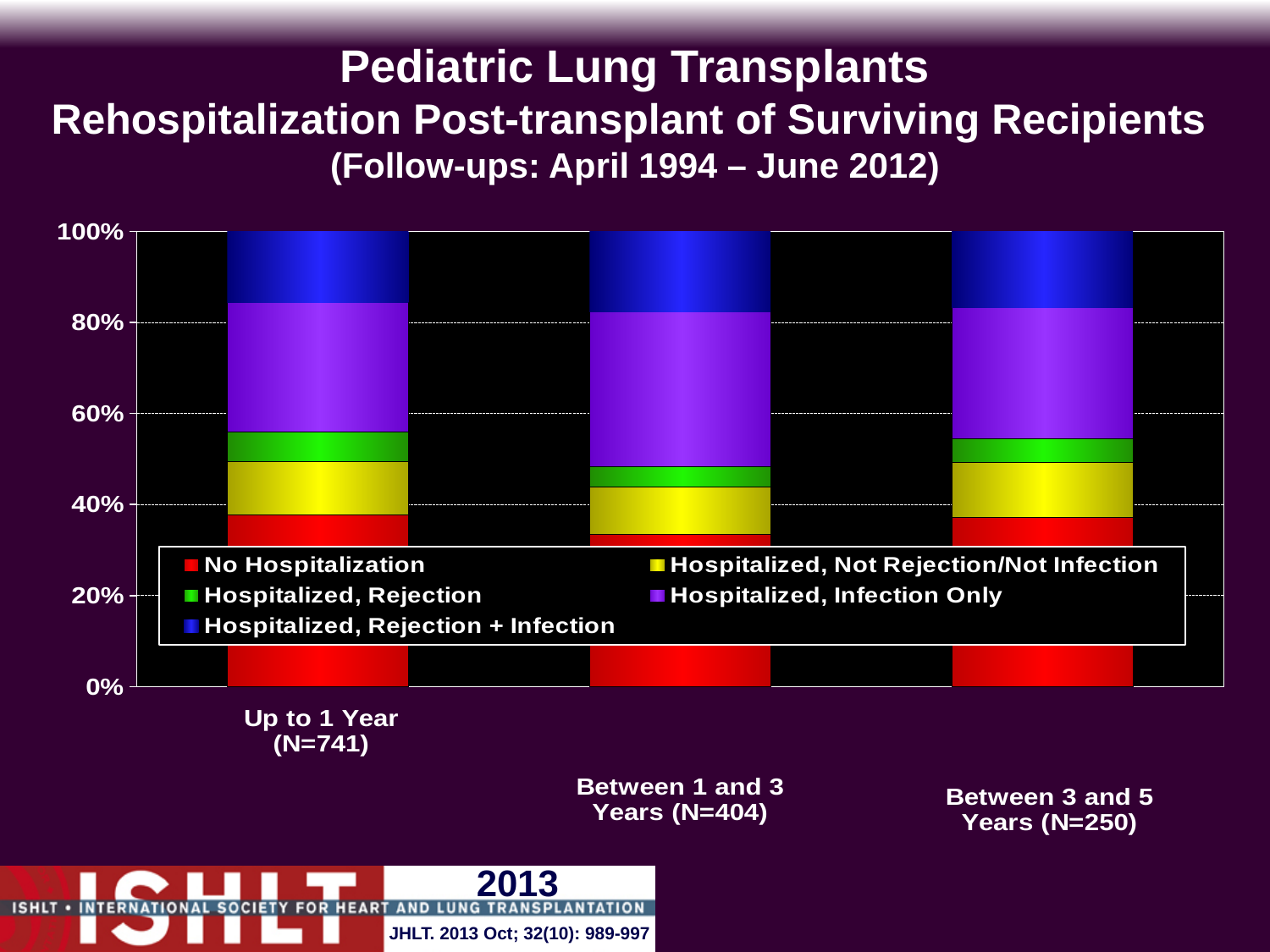
Which follow-up period has the largest Hospitalized, Infection Only segment? Between 1 and 3 Years (N=404) Is the Hospitalized, Infection Only value for Between 1 and 3 Years (N=404) greater or less than 20%? greater Which colour represents No Hospitalization in the legend? red How many follow-up period categories are shown on the x axis? 3 What is the total of the stacked bar for Up to 1 Year (N=741)? 100% Which follow-up period has the smallest No Hospitalization segment? Between 1 and 3 Years (N=404) Is the No Hospitalization value for Between 1 and 3 Years (N=404) greater or less than 40%? less Is the No Hospitalization value for Up to 1 Year (N=741) greater or less than 40%? less How many series does the legend list? 5 What is the N for the Between 3 and 5 Years category? 250 What kind of chart is shown on the slide? stacked bar chart